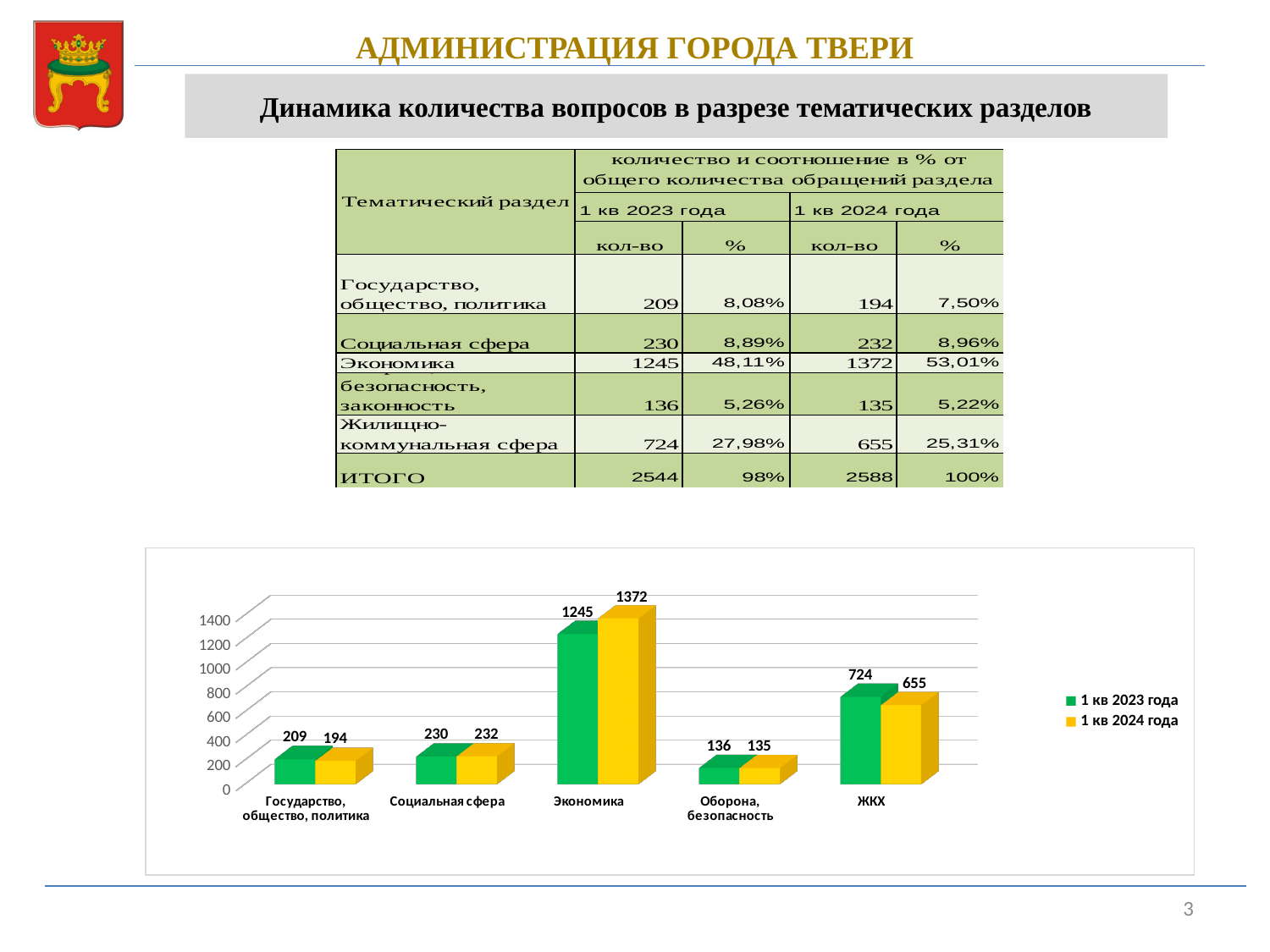
How many categories are shown on the x axis of the chart? 5 What is the value for Оборона, безопасность in the 1 кв 2024 года series? 135 Which is larger for Государство, общество, политика: the 1 кв 2023 года value or the 1 кв 2024 года value? 1 кв 2023 года What kind of chart is shown on the slide? Bar chart What is the value for ЖКХ in the 1 кв 2023 года series? 724 Which category has the highest value in the 1 кв 2023 года series? Экономика How many series does the chart legend list? 2 Which category has the lowest value in the 1 кв 2024 года series? Оборона, безопасность What is the difference between the 1 кв 2024 года and 1 кв 2023 года values for Экономика? 127 What is the difference between the 1 кв 2023 года and 1 кв 2024 года values for ЖКХ? 69 What is the value for Экономика in the 1 кв 2024 года series? 1372 What colour represents the 1 кв 2024 года series in the chart? Yellow